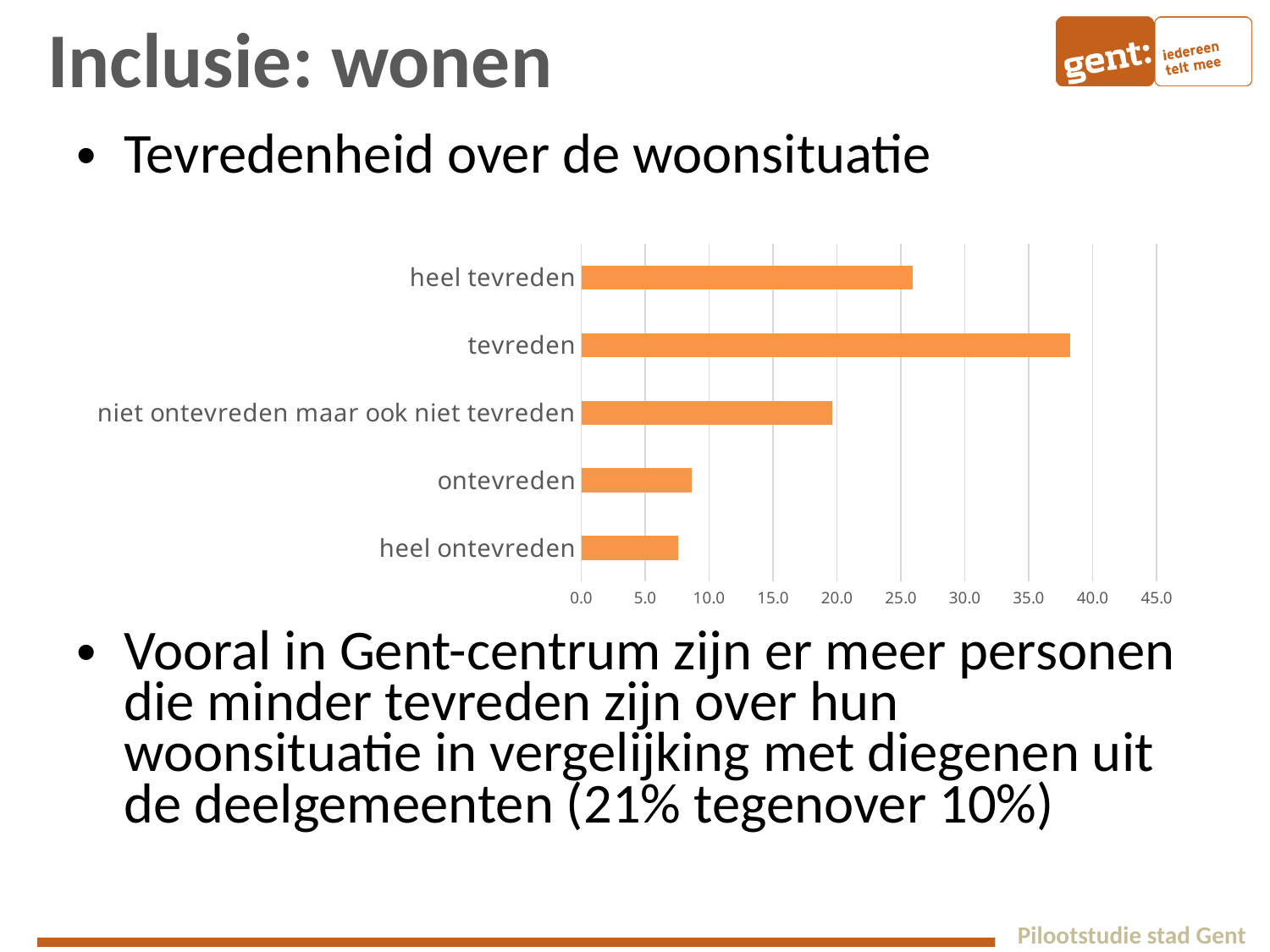
Is the value for 'tevreden' greater or less than 35.0? greater How many categories are shown in the chart? 5 Is the value for 'heel ontevreden' greater or less than 10.0? less Which is larger, the value for 'heel tevreden' or the value for 'niet ontevreden maar ook niet tevreden'? heel tevreden Which is larger, the value for 'tevreden' or the value for 'heel tevreden'? tevreden Is the value for 'niet ontevreden maar ook niet tevreden' greater or less than 15.0? greater What colour are the bars in the chart? orange What kind of chart is shown on the slide? bar chart Which category has the highest value in the chart? tevreden